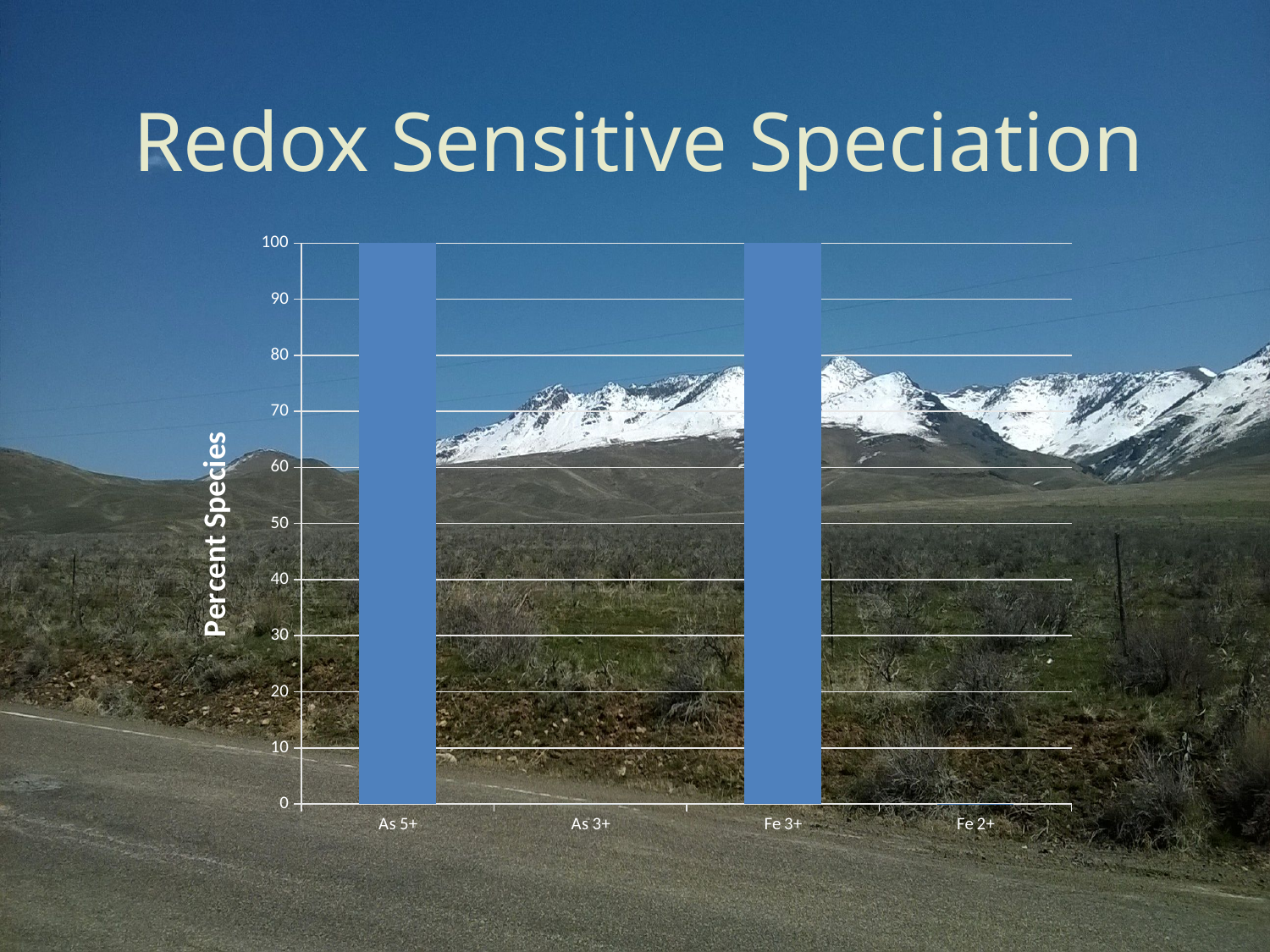
Is the value for Fe 2+ greater or less than 10? less What is the title of the slide containing the chart? Redox Sensitive Speciation Is the value for Fe 3+ greater or less than 90? greater Which is larger, the value for As 5+ or the value for As 3+? As 5+ How many categories are shown on the x axis of the chart? 4 What is the title of the y axis of the chart? Percent Species What is the value for As 5+ in the chart? 100 What is the difference between the values for As 5+ and Fe 3+? 0 Which is larger, the value for Fe 3+ or the value for Fe 2+? Fe 3+ Is the value for As 3+ greater or less than 10? less What is the value for Fe 3+ in the chart? 100 What kind of chart is shown on the slide? bar chart